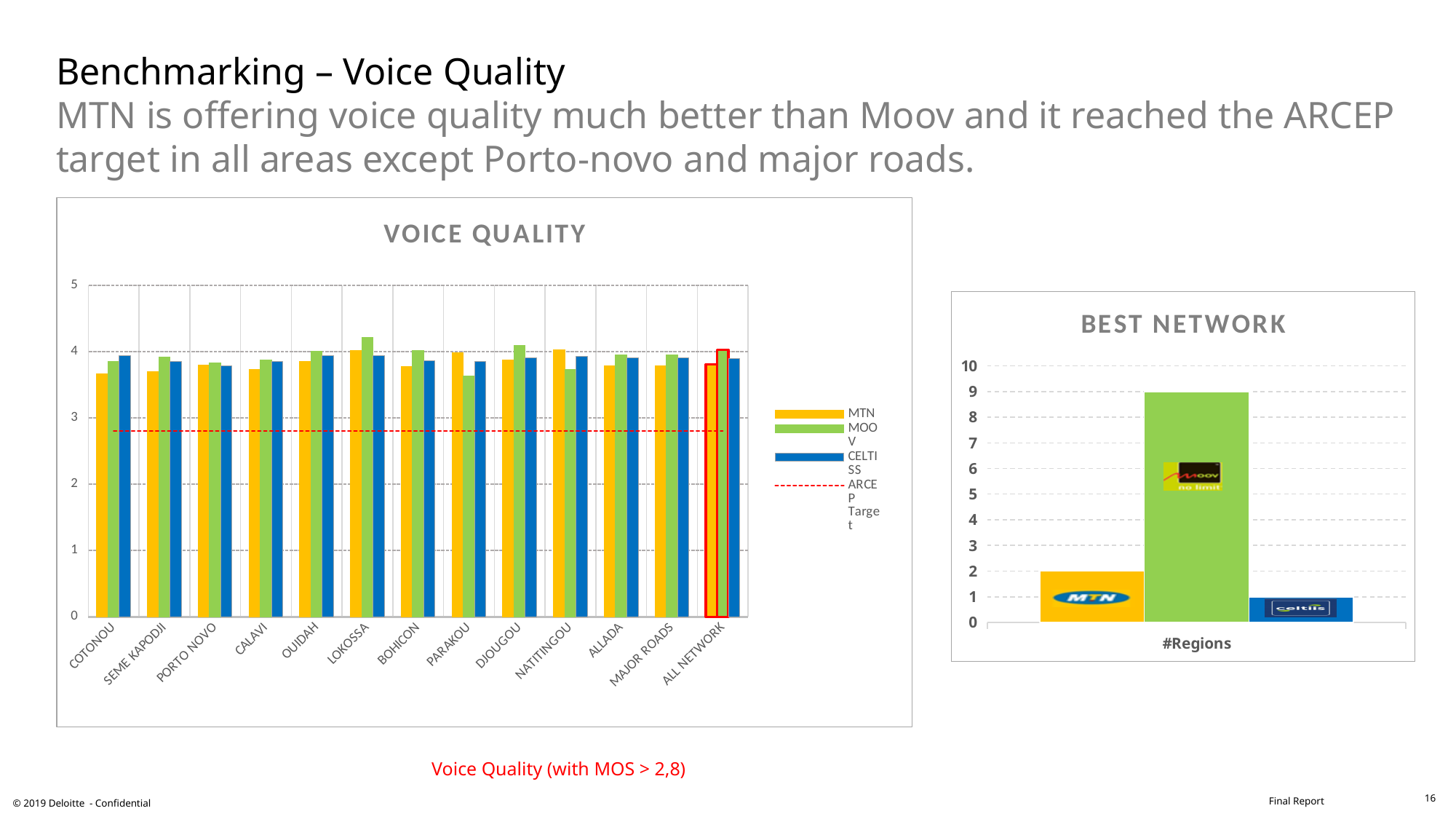
In the BEST NETWORK chart, what is the difference between the Moov value and the MTN value? 7 In the VOICE QUALITY chart, which is larger for PARAKOU, the MTN value or the MOOV value? MTN How many categories are shown on the x axis of the VOICE QUALITY chart? 13 In the VOICE QUALITY chart, is the ARCEP Target line greater or less than 3? less In the BEST NETWORK chart, which network has the highest bar? Moov In the BEST NETWORK chart, what is the value for MTN? 2 How many series does the legend of the VOICE QUALITY chart list? 4 What kind of chart is the VOICE QUALITY chart? bar chart In the VOICE QUALITY chart, is the MOOV value for LOKOSSA greater or less than 4? greater In the VOICE QUALITY chart, which category has the lowest MOOV value? PARAKOU In the BEST NETWORK chart, what is the value for Moov? 9 In the VOICE QUALITY chart, is the MTN value for COTONOU greater or less than 4? less